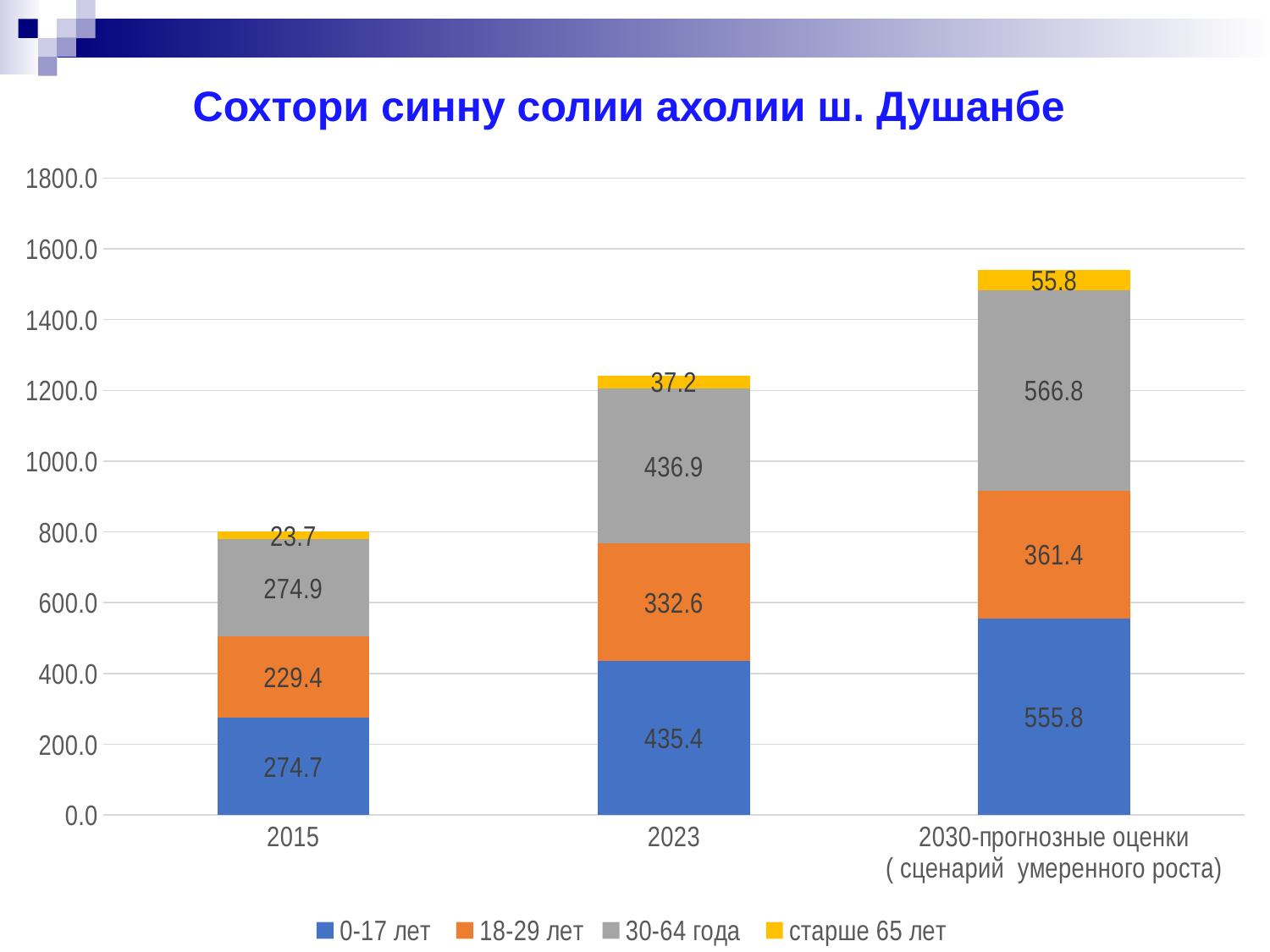
What is the difference between the 0-17 лет values for 2030 and 2015? 281.1 What is the value for the 30-64 года series in the 2030 forecast category? 566.8 What type of chart is shown on the slide? Stacked bar chart Which category has the highest value for the 18-29 лет series? 2030-прогнозные оценки (сценарий умеренного роста) What is the total of the stacked bar for 2015? 802.7 Which category has the lowest value for the 30-64 года series? 2015 What is the value for the 0-17 лет series in 2023? 435.4 How many categories are shown on the x axis? 3 What is the value for the старше 65 лет series in 2015? 23.7 Which is larger in 2023: the 18-29 лет value or the 30-64 года value? 30-64 года How many series does the legend list? 4 Do the total bar heights rise or fall from 2015 to the 2030 forecast? Rise